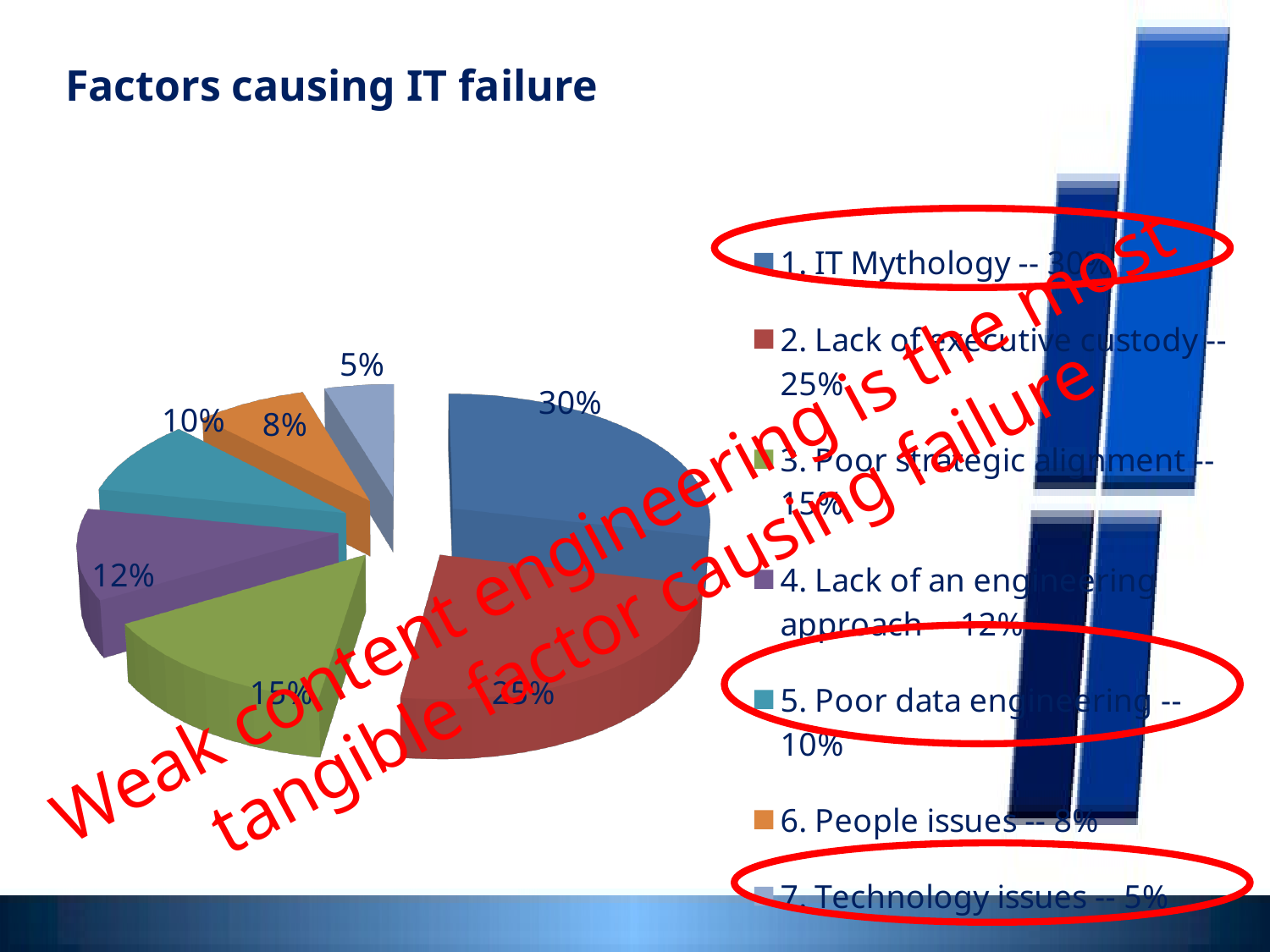
What percentage is shown for IT Mythology? 30% Which factor has the largest share of the pie? 1. IT Mythology Which factor has the smallest share of the pie? 7. Technology issues What type of chart is shown on the slide? pie chart What percentage is shown for Technology issues? 5% What is the title of the chart? Factors causing IT failure What is the difference between the shares for IT Mythology and Lack of executive custody? 5% What percentage is shown for Poor data engineering? 10% What percentage is shown for Lack of executive custody? 25% What percentage is shown for People issues? 8% How many slices does the pie chart have? 7 Which is larger, the share for Poor strategic alignment or the share for Lack of an engineering approach? Poor strategic alignment